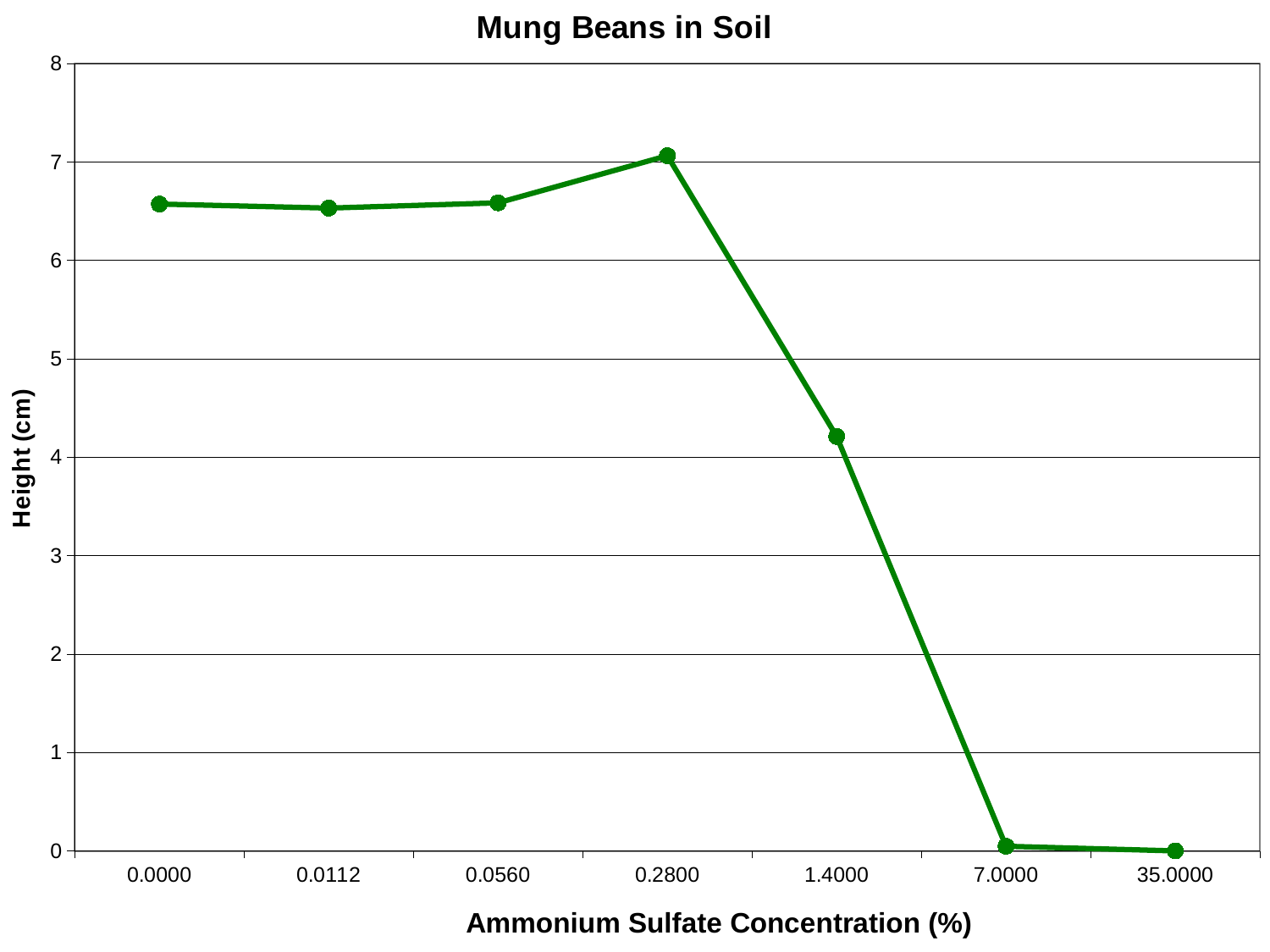
What kind of chart is shown on the slide? line chart Does the height rise or fall between 0.2800% and 7.0000% ammonium sulfate? fall At which ammonium sulfate concentration is the height lowest? 35.0000 Is the height at 1.4000% ammonium sulfate greater or less than 5 cm? less Which has the greater height: 0.2800% or 1.4000% ammonium sulfate? 0.2800 How many data points are plotted on the line? 7 Is the height at 7.0000% ammonium sulfate greater or less than 1 cm? less Is the height at 0.0000% ammonium sulfate greater or less than 6 cm? greater At which ammonium sulfate concentration is the height highest? 0.2800 What is the label of the y axis? Height (cm) What is the title of the chart? Mung Beans in Soil